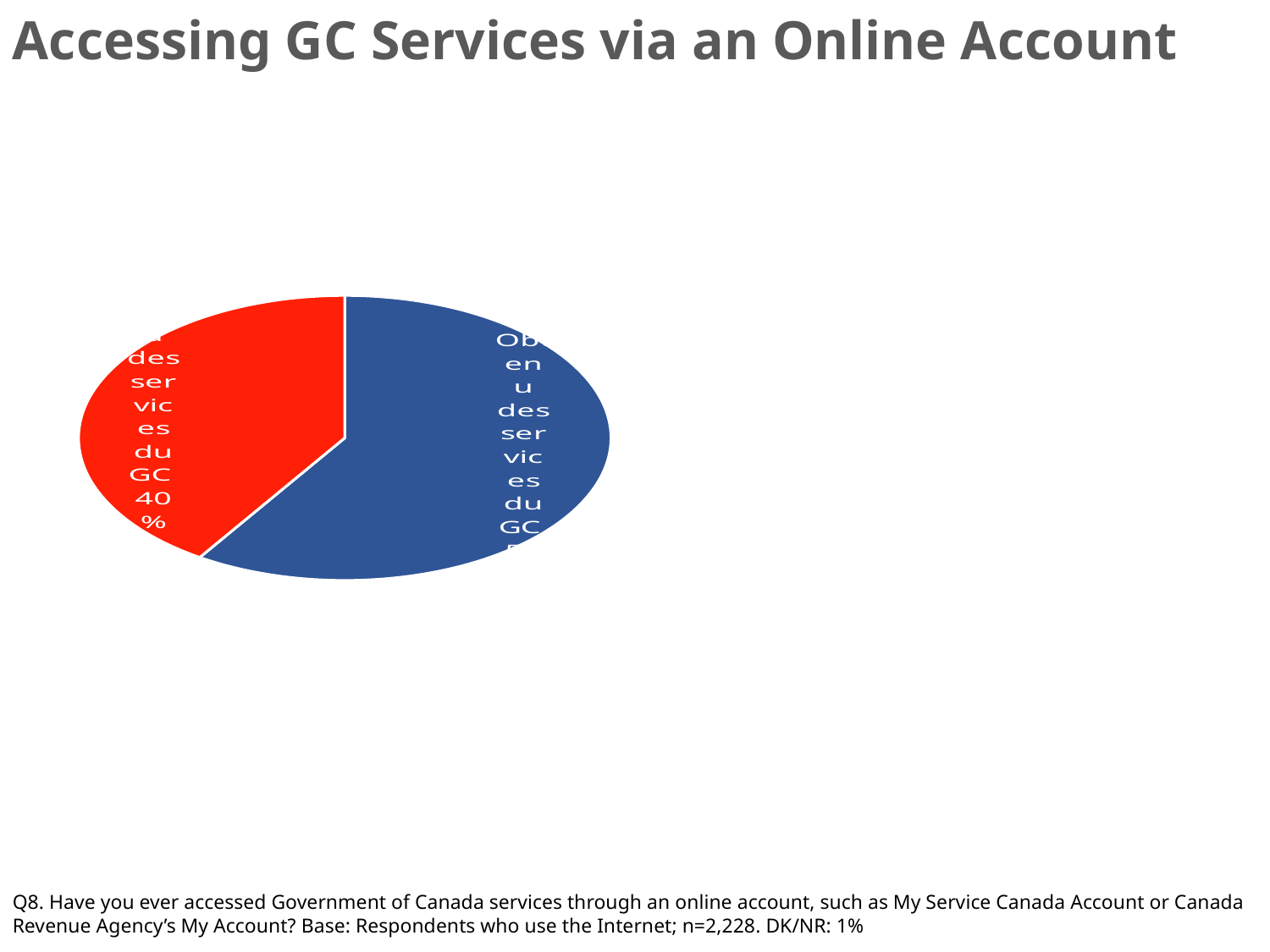
What colour is the largest slice of the pie chart? blue Which slice of the pie chart is larger, the red slice or the blue slice? the blue slice What share of the pie does the red slice represent? 40% What percentage is shown on the red slice of the pie chart? 40% How many slices does the pie chart have? 2 What is the title of the slide containing the pie chart? Accessing GC Services via an Online Account What kind of chart is shown on the slide? pie chart Which slice of the pie chart is the smallest? the red slice (40%)